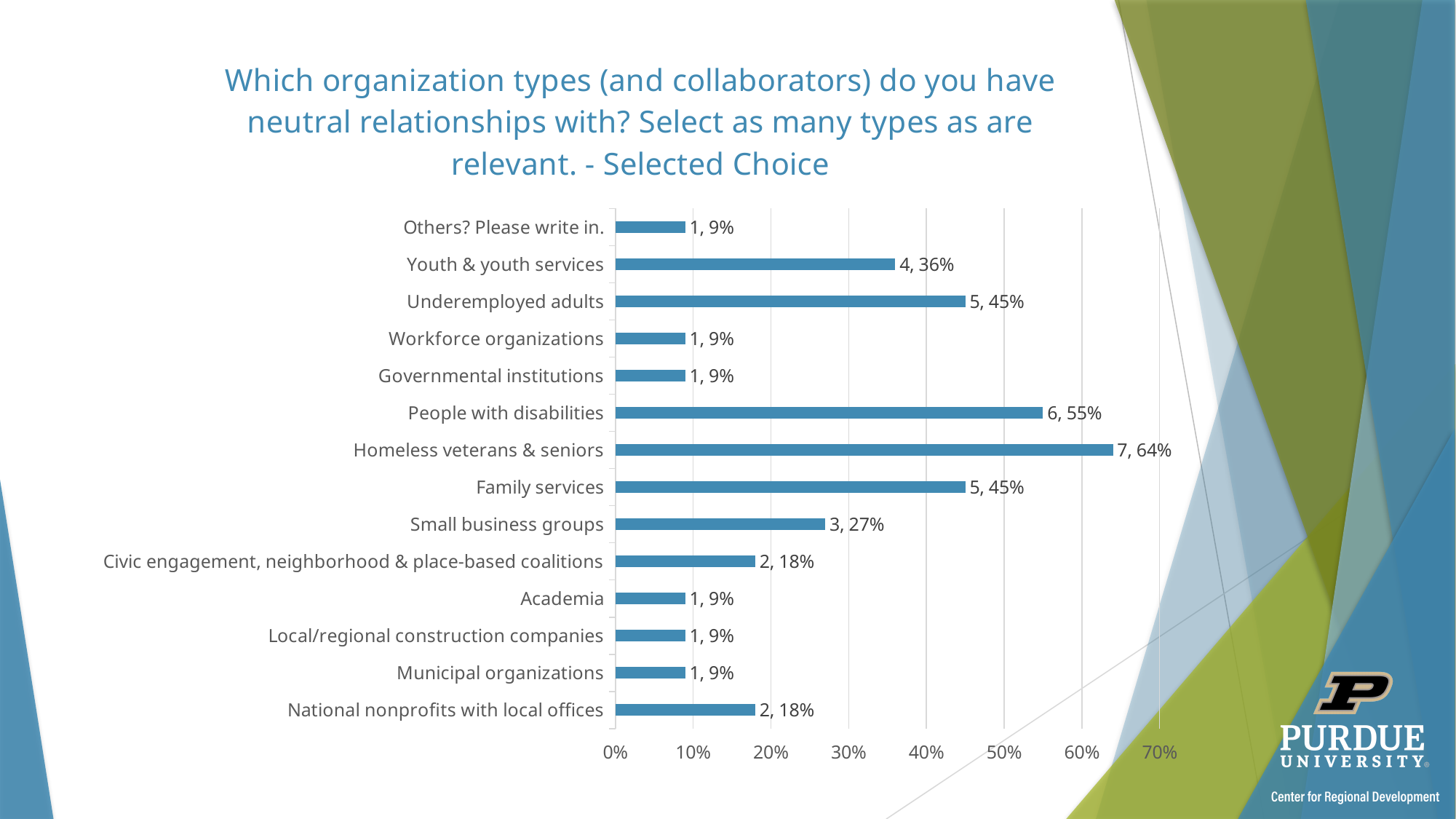
What count is shown for Small business groups? 3 Which is larger, the value for Underemployed adults or the value for Youth & youth services? Underemployed adults What percentage is shown for Youth & youth services? 36% Is the value for Family services greater or less than 40%? greater How many categories have a value of 9%? 6 What is the data label shown for Homeless veterans & seniors? 7, 64% What is the difference in percentage points between Homeless veterans & seniors and People with disabilities? 9 What is the highest value shown on the x axis? 70% Which category has the highest value? Homeless veterans & seniors How many categories are shown on the chart? 14 What kind of chart is shown on the slide? bar chart What percentage is shown for People with disabilities? 55%